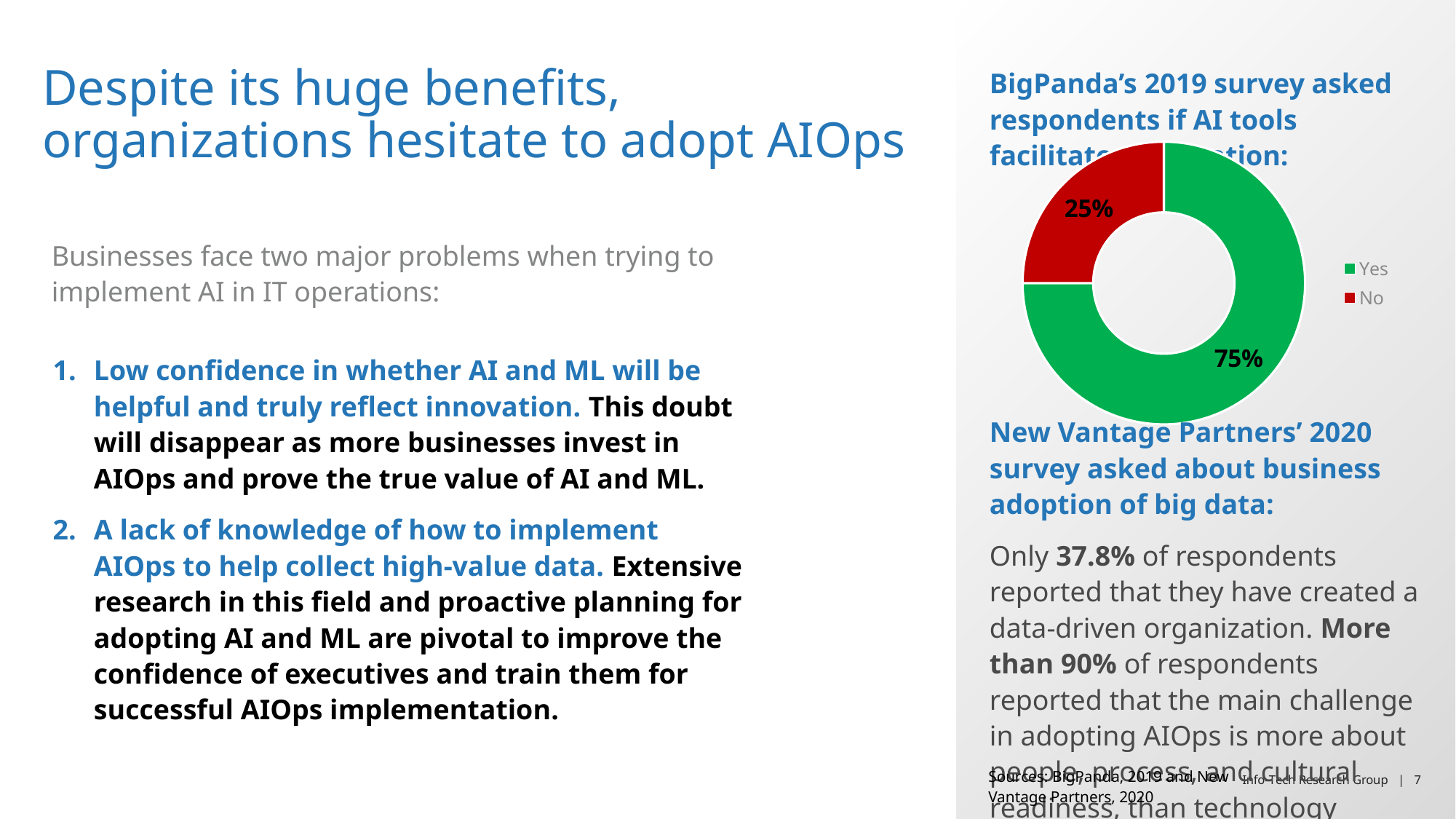
What percentage of respondents answered Yes in the donut chart? 75% What type of chart is shown on the slide? Donut (pie) chart What share of the donut chart does the No slice represent? 25% What is the difference in percentage points between the Yes and No shares in the donut chart? 50 How many entries does the legend of the donut chart list? 2 What colour represents the No response in the donut chart? Red What colour represents the Yes response in the donut chart? Green Which is larger in the donut chart, the Yes share or the No share? Yes What percentage of respondents answered No in the donut chart? 25% How many categories does the donut chart show? 2 Which response has the smallest share in the donut chart? No Which response has the largest share in the donut chart? Yes